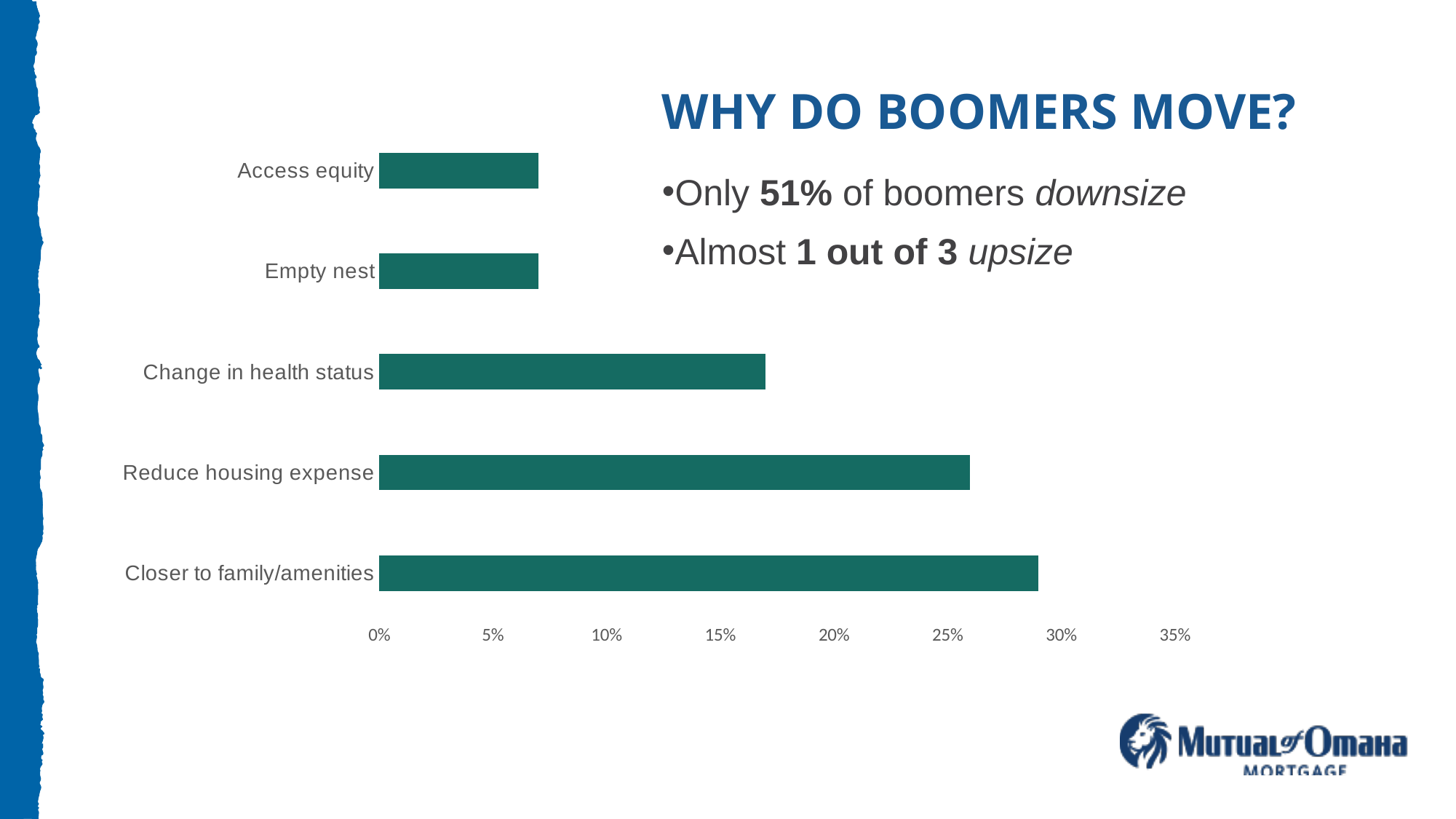
Is the value for Access equity greater or less than 10%? less Is the value for Reduce housing expense greater or less than 30%? less What is the highest value shown on the horizontal axis of the chart? 35% Is the value for Change in health status greater or less than 15%? greater Which is larger, the value for Reduce housing expense or the value for Change in health status? Reduce housing expense What kind of chart is shown on the slide? bar chart Which is larger, the value for Change in health status or the value for Empty nest? Change in health status What is the title of the slide containing the chart? WHY DO BOOMERS MOVE? How many categories (reasons) are plotted in the bar chart? 5 Which reason has the highest value in the bar chart? Closer to family/amenities